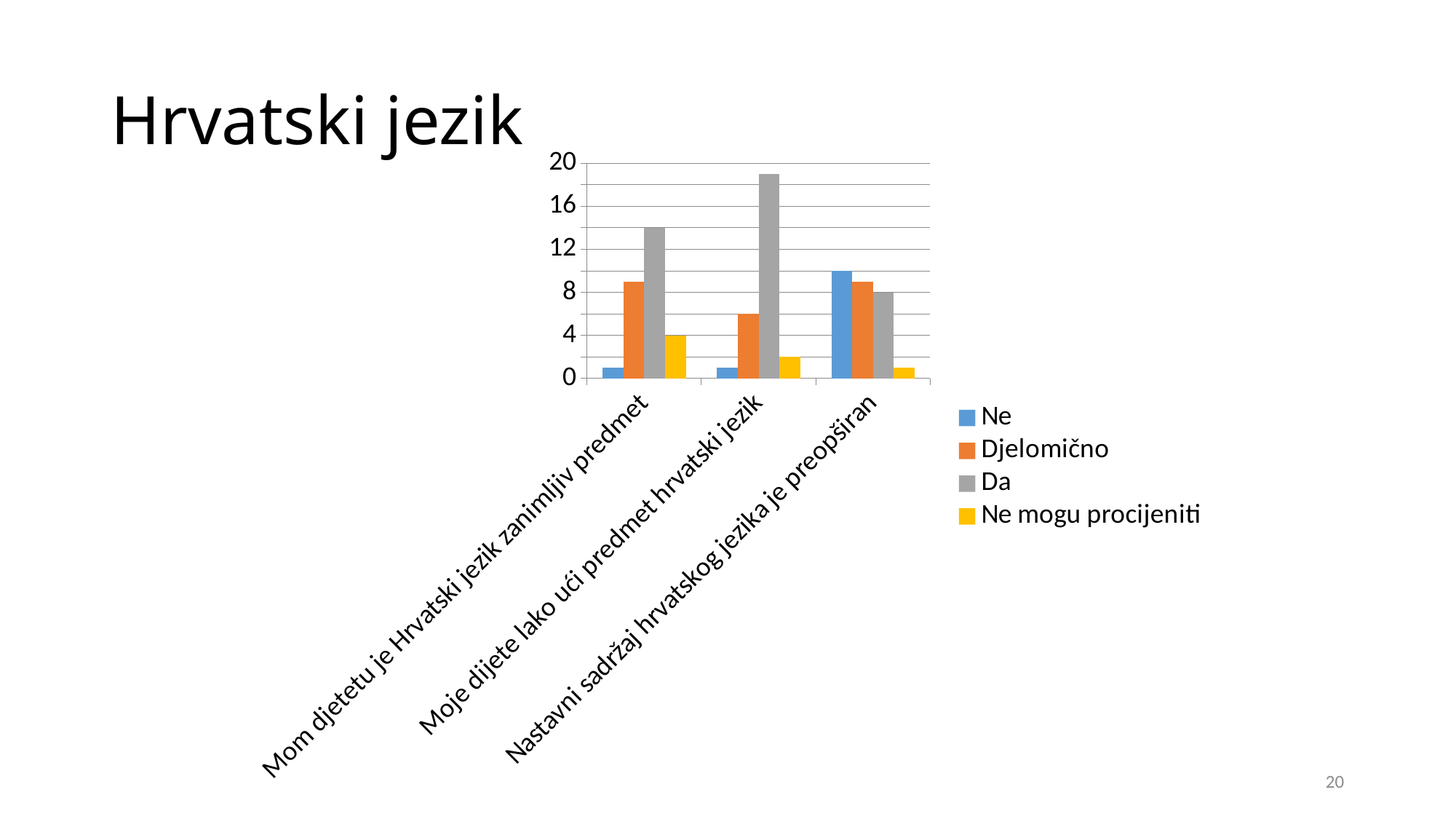
What is the value of "Da" for "Nastavni sadržaj hrvatskog jezika je preopširan"? 8 Is the value of "Da" for "Moje dijete lako uči predmet hrvatski jezik" greater or less than 16? greater How many categories are shown on the x axis? 3 For "Nastavni sadržaj hrvatskog jezika je preopširan", which is larger, "Ne" or "Da"? Ne Is the value of "Djelomično" for "Moje dijete lako uči predmet hrvatski jezik" greater or less than 8? less What is the value of "Ne mogu procijeniti" for "Mom djetetu je Hrvatski jezik zanimljiv predmet"? 4 Which category has the highest "Ne" value? Nastavni sadržaj hrvatskog jezika je preopširan Is the value of "Da" for "Mom djetetu je Hrvatski jezik zanimljiv predmet" greater or less than 12? greater What kind of chart is shown on the slide? bar chart Which category has the highest "Da" value? Moje dijete lako ući predmet hrvatski jezik What is the title of the slide containing the chart? Hrvatski jezik How many series does the legend list? 4